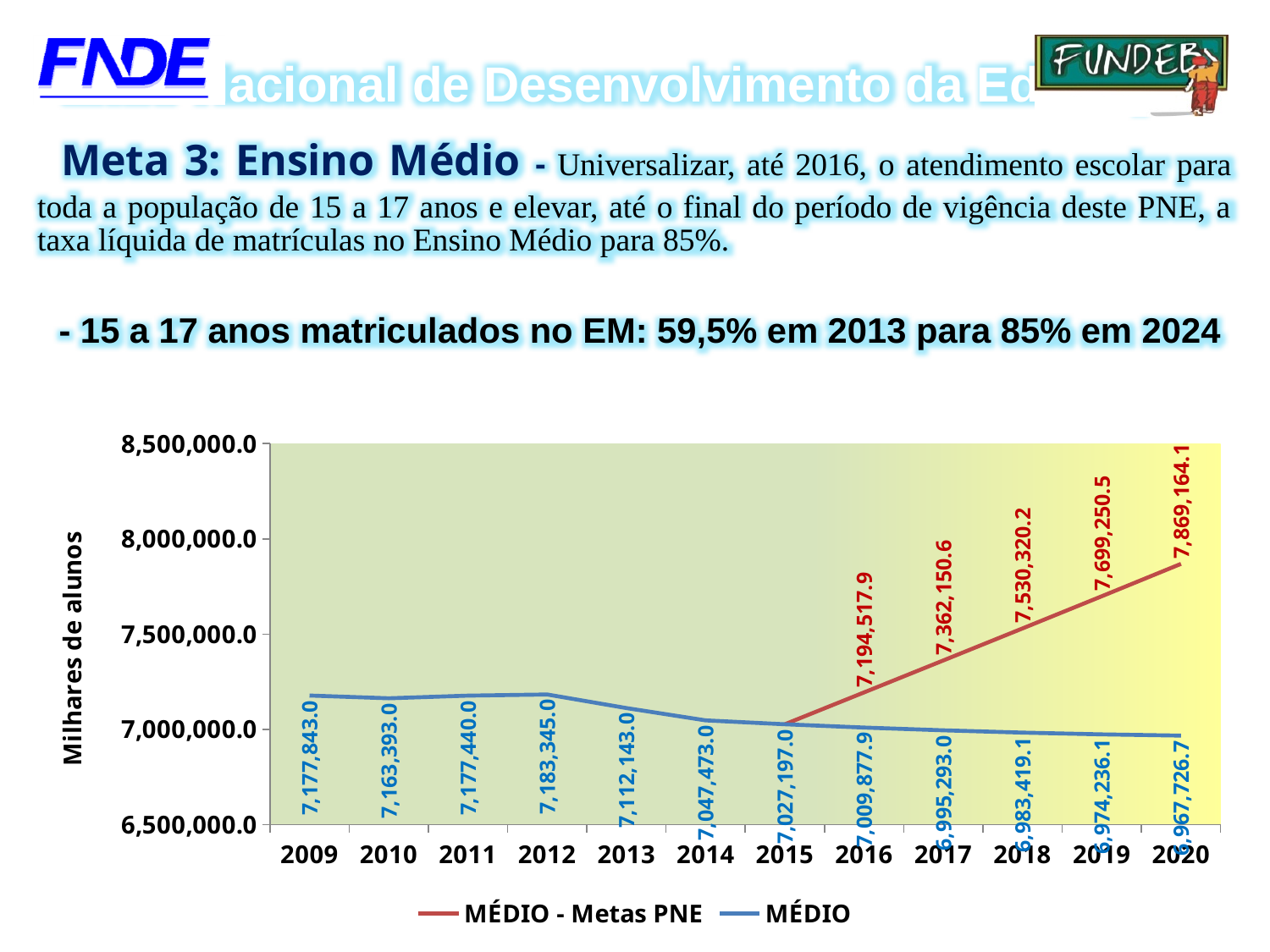
What is the value of the MÉDIO series for 2009? 7,177,843.0 Which series has the larger value in 2018, MÉDIO - Metas PNE or MÉDIO? MÉDIO - Metas PNE In which year does the MÉDIO series reach its highest value? 2012 What is the difference between the MÉDIO - Metas PNE value and the MÉDIO value in 2020? 901,437.4 What kind of chart is shown on the slide? line chart How many years are shown on the x axis of the chart? 12 In which year does the MÉDIO series reach its lowest value? 2020 What is the value of the MÉDIO - Metas PNE series for 2017? 7,362,150.6 Is the MÉDIO - Metas PNE value for 2019 greater or less than 7,500,000.0? greater What is the value of the MÉDIO - Metas PNE series for 2020? 7,869,164.1 What is the value of the MÉDIO series for 2015? 7,027,197.0 How many series does the chart legend list? 2